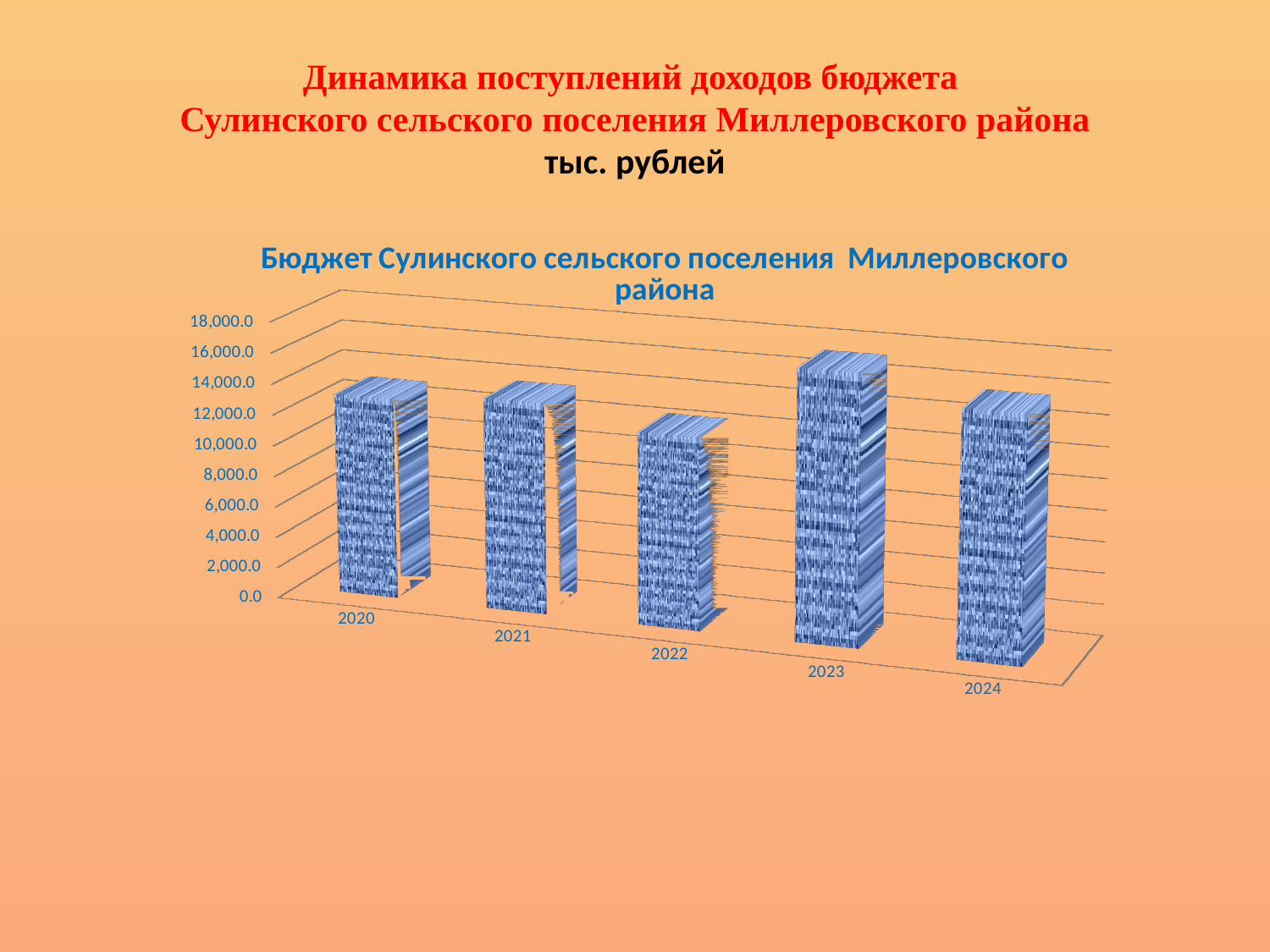
Which year has the larger value, 2020 or 2022? 2020 What kind of chart is shown on the slide? bar chart Which year has the highest budget revenue in the chart? 2023 How many years are shown on the x axis of the chart? 5 Which year has the larger value, 2023 or 2022? 2023 Is the value for 2021 greater or less than 16,000.0? less Is the value for 2023 greater or less than 12,000.0? greater What is the title of the chart? Бюджет Сулинского сельского поселения Миллеровского района Which year has the lowest budget revenue in the chart? 2022 Is the value for 2024 greater or less than 10,000.0? greater In what units are the values on the chart expressed, according to the slide heading? тыс. рублей